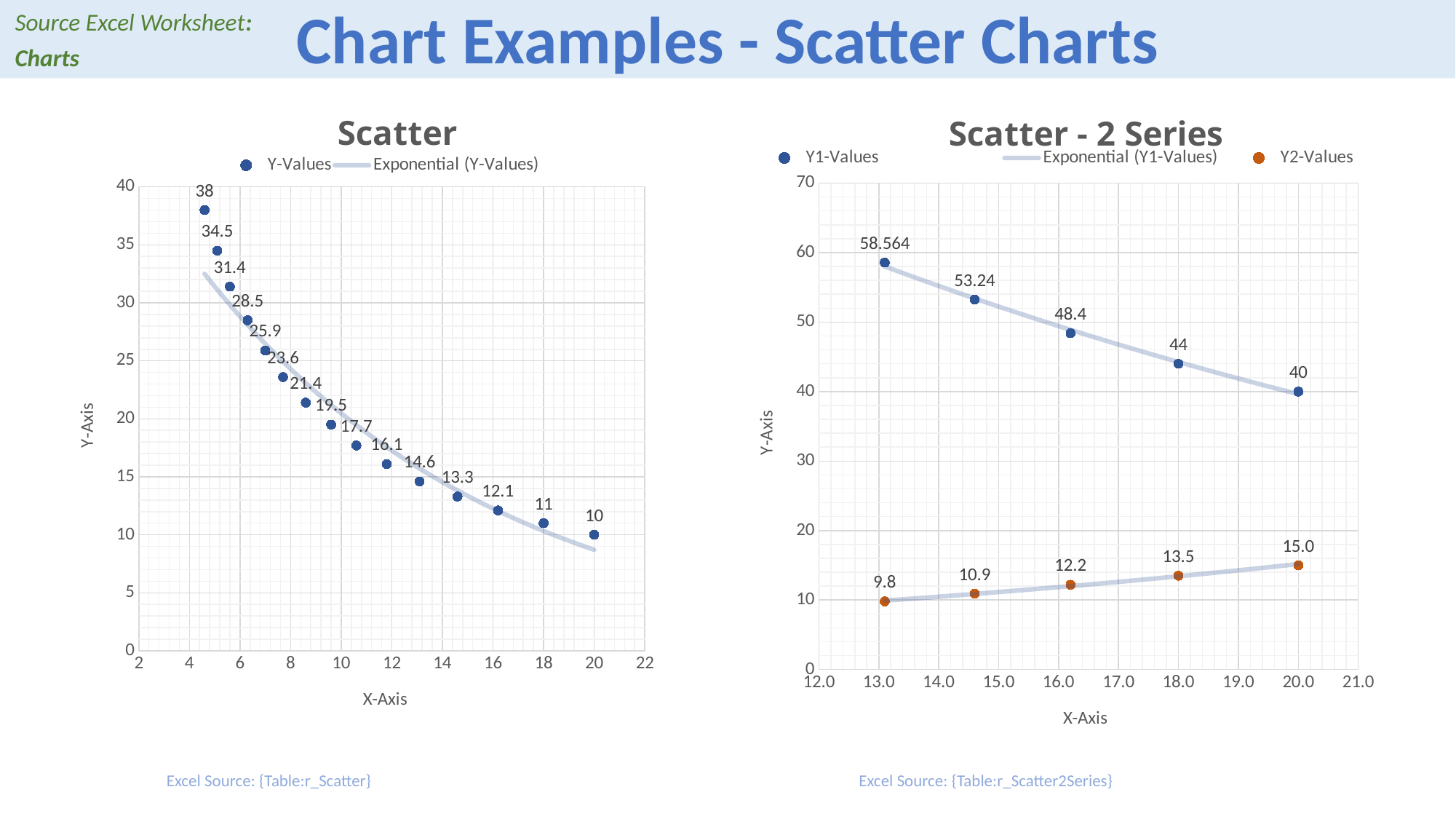
In the right chart titled "Scatter - 2 Series", what is the highest Y1-Values data label? 58.564 What kind of chart is the left chart titled "Scatter"? Scatter chart In the right chart titled "Scatter - 2 Series", what is the Y1-Values data label at X-Axis value 20.0? 40 In the left chart titled "Scatter", what is the lowest Y-Values data label? 10 In the left chart titled "Scatter", what is the difference between the highest and lowest Y-Values data labels? 28 In the right chart titled "Scatter - 2 Series", do the Y2-Values rise or fall as the X-Axis value increases? Rise In the right chart titled "Scatter - 2 Series", how many entries does the legend list? 3 In the right chart titled "Scatter - 2 Series", what is the Y2-Values data label at X-Axis value 20.0? 15.0 In the left chart titled "Scatter", do the Y-Values rise or fall as the X-Axis value increases? Fall In the left chart titled "Scatter", how many data points are plotted for Y-Values? 15 In the right chart titled "Scatter - 2 Series", which series has the larger value at X-Axis value 18.0, Y1-Values or Y2-Values? Y1-Values In the left chart titled "Scatter", what is the highest Y-Values data label? 38